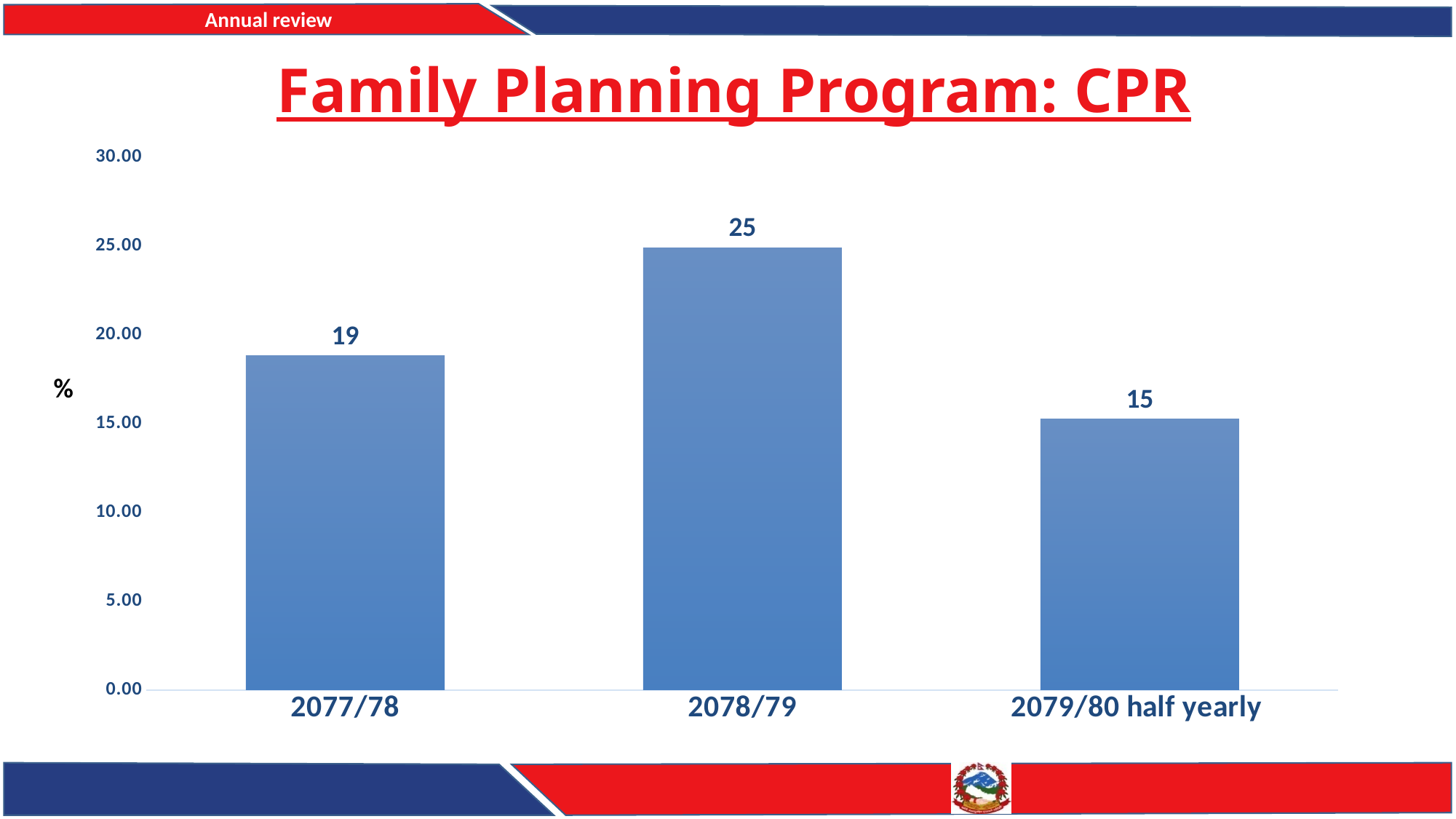
What is the value for 2079/80 half yearly? 15 What is the value for 2077/78? 19 Which category has the lowest value? 2079/80 half yearly What is the title of the chart? Family Planning Program: CPR Which category has the highest value? 2078/79 What is the value for 2078/79? 25 What is the difference between the values for 2077/78 and 2079/80 half yearly? 4 Is the value for 2078/79 greater or less than 20.00? greater What is the difference between the values for 2078/79 and 2077/78? 6 What kind of chart is shown on the slide? bar chart Which is larger, the value for 2077/78 or the value for 2079/80 half yearly? 2077/78 How many categories are shown on the x axis? 3